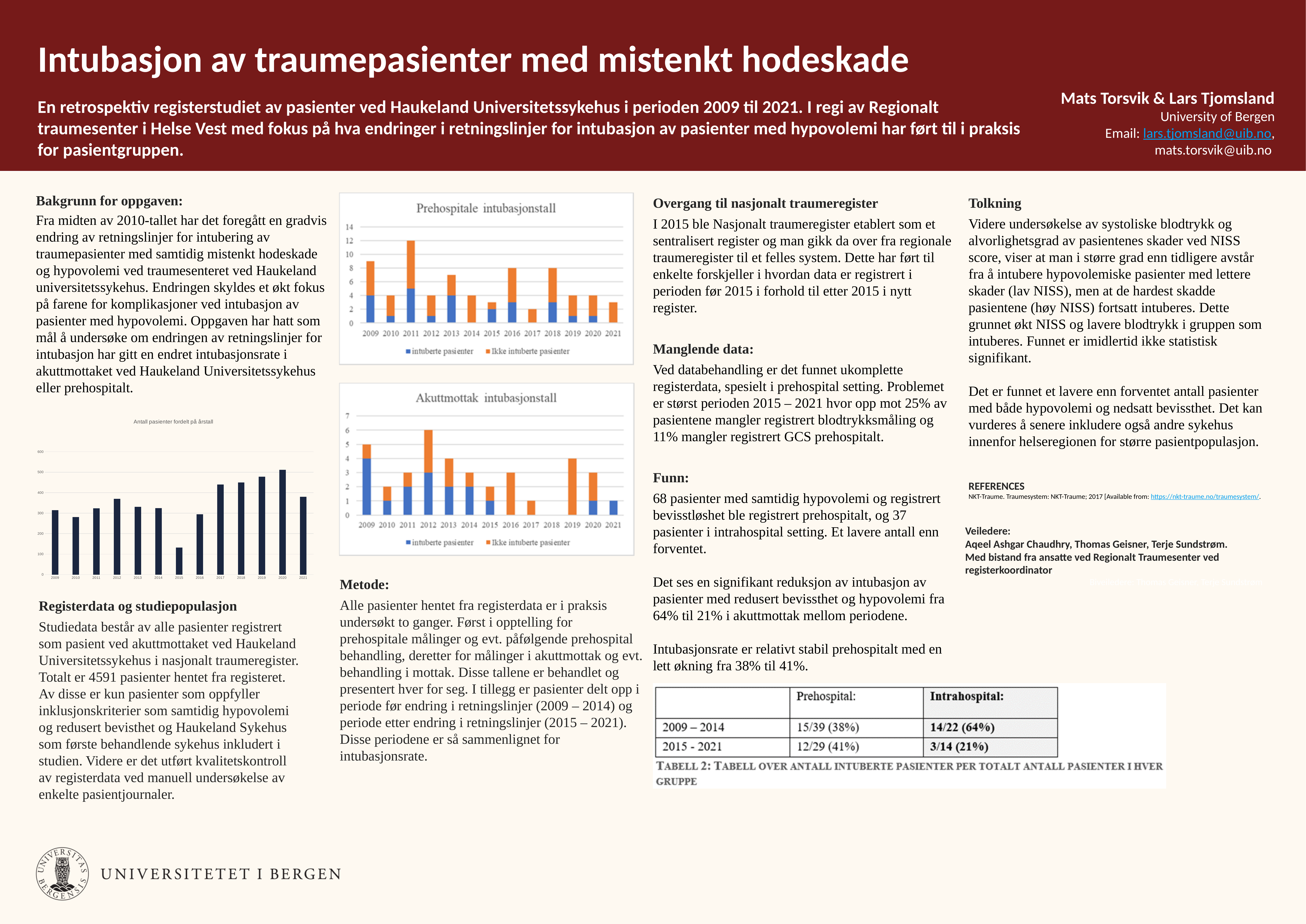
In the 'Prehospitale intubasjonstall' chart, which year has the highest total bar? 2011 In the 'Akuttmottak intubasjonstall' chart, what is the total height of the stacked bar for 2012? 6 How many series does the legend of the 'Akuttmottak intubasjonstall' chart list? 2 In the 'Akuttmottak intubasjonstall' chart, which year has the highest total bar? 2012 In the 'Prehospitale intubasjonstall' chart, what is the total height of the stacked bar for 2011? 12 What kind of chart is the 'Prehospitale intubasjonstall' chart? Stacked bar chart In the 'Akuttmottak intubasjonstall' chart, is the total bar for 2009 larger or smaller than the total bar for 2010? Larger In the 'Antall pasienter fordelt på årstall' chart, is the value for 2015 greater or less than 200? less In the 'Antall pasienter fordelt på årstall' chart, is the value for 2017 greater or less than 400? greater In the 'Antall pasienter fordelt på årstall' chart, which year has the lowest bar? 2015 How many years are shown on the x axis of the 'Prehospitale intubasjonstall' chart? 13